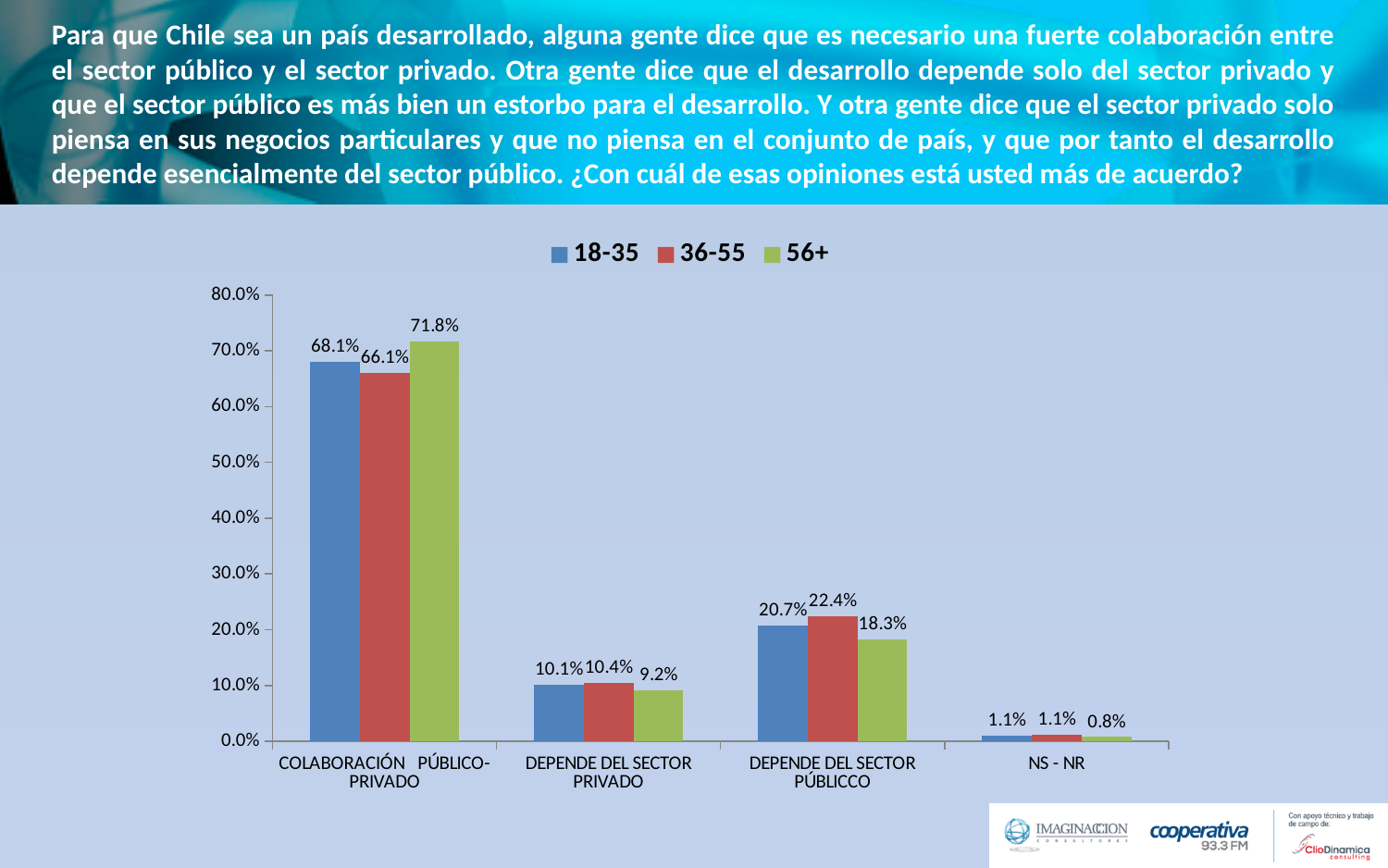
What is the value for the 36-55 series in the DEPENDE DEL SECTOR PRIVADO category? 10.4% How many series does the legend list? 3 What is the difference between the 56+ and 36-55 values in the COLABORACIÓN PÚBLICO-PRIVADO category? 5.7% Is the value for the 18-35 series in the COLABORACIÓN PÚBLICO-PRIVADO category greater or less than 60.0%? greater Which series is shown in green in the legend? 56+ What is the value for the 56+ series in the COLABORACIÓN PÚBLICO-PRIVADO category? 71.8% Which category has the lowest value for the 56+ series? NS - NR Which category has the highest value for the 18-35 series? COLABORACIÓN PÚBLICO-PRIVADO What kind of chart is shown on the slide? bar chart What is the value for the 18-35 series in the DEPENDE DEL SECTOR PÚBLICCO category? 20.7% How many categories are shown on the x axis? 4 In the DEPENDE DEL SECTOR PÚBLICCO category, which is larger: the 36-55 value or the 56+ value? 36-55